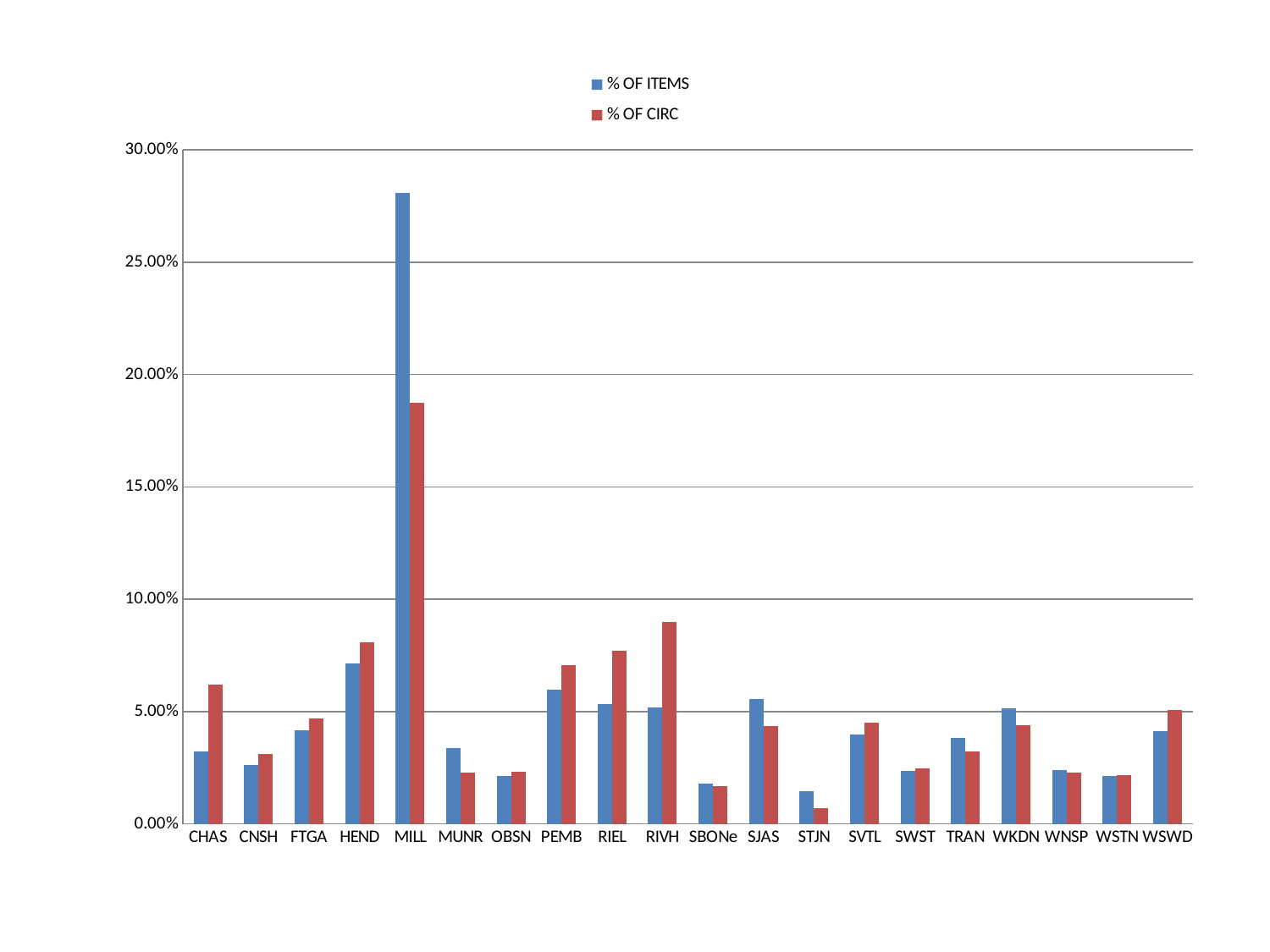
For SJAS, which is larger: % OF ITEMS or % OF CIRC? % OF ITEMS How many categories are shown on the x axis? 20 Which category has the highest % OF ITEMS value? MILL For CHAS, which is larger: % OF ITEMS or % OF CIRC? % OF CIRC How many series does the legend list? 2 Is the % OF CIRC value for RIVH greater or less than 10.00%? less Is the % OF CIRC value for HEND greater or less than 5.00%? greater What kind of chart is shown on the slide? bar chart Which category has the highest % OF CIRC value? MILL Is the % OF ITEMS value for MILL greater or less than 25.00%? greater Which category has the lowest % OF CIRC value? STJN